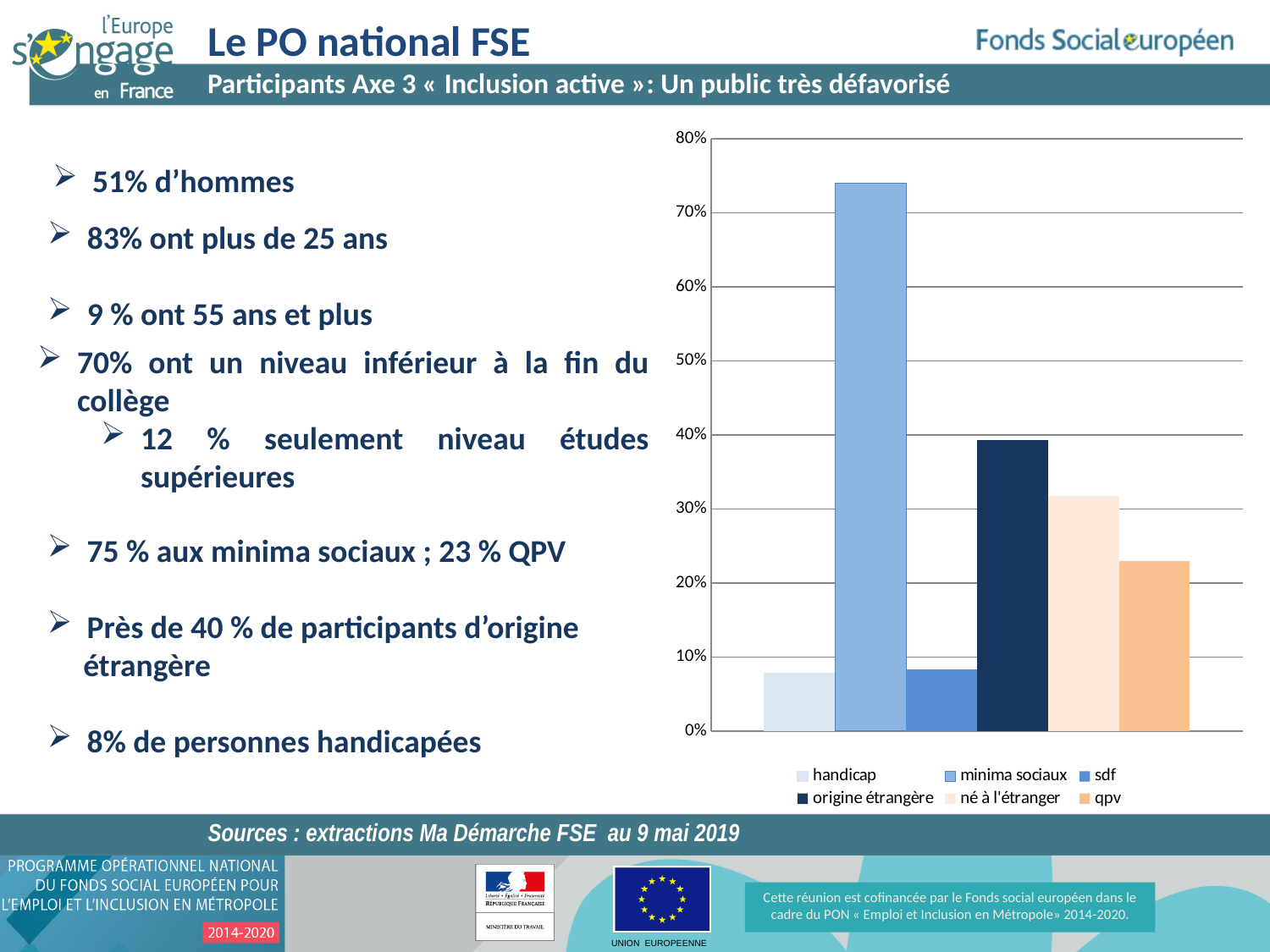
Is the value for qpv greater or less than 20%? greater How many series does the chart legend list? 6 Is the value for né à l'étranger greater or less than 40%? less What kind of chart is shown on the slide? bar chart Is the value for handicap greater or less than 10%? less What is the highest value shown on the chart's vertical axis? 80% Which is larger, the value for né à l'étranger or the value for sdf? né à l'étranger How many bars are plotted in the chart? 6 Which series has the highest bar in the chart? minima sociaux Which is larger, the value for origine étrangère or the value for qpv? origine étrangère